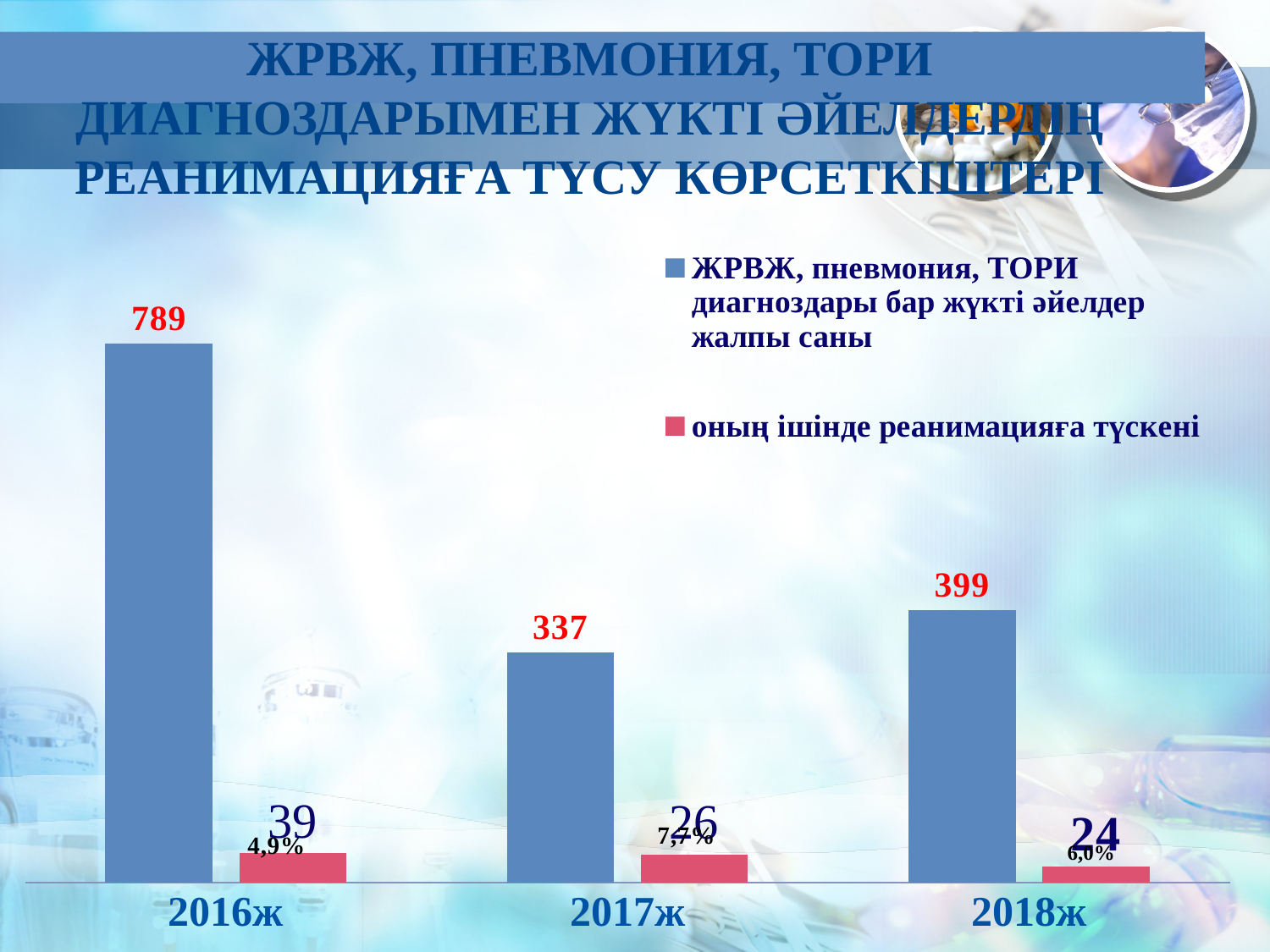
What is the value of the blue series (ЖРВЖ, пневмония, ТОРИ диагноздары бар жүкті әйелдер жалпы саны) for 2016ж? 789 In which year is the blue series (total number of pregnant women) highest? 2016ж What is the value of the blue series for 2017ж? 337 What is the difference between the blue series values for 2016ж and 2018ж? 390 Which is larger: the red series value for 2017ж or for 2018ж? 2017ж What is the value of the blue series for 2018ж? 399 How many series does the legend list? 2 How many year categories are shown on the x axis? 3 What is the value of the red series (оның ішінде реанимацияға түскені) for 2018ж? 24 What type of chart is shown on the slide? bar chart What is the value of the red series (оның ішінде реанимацияға түскені) for 2016ж? 39 In which year is the blue series (total number of pregnant women) lowest? 2017ж